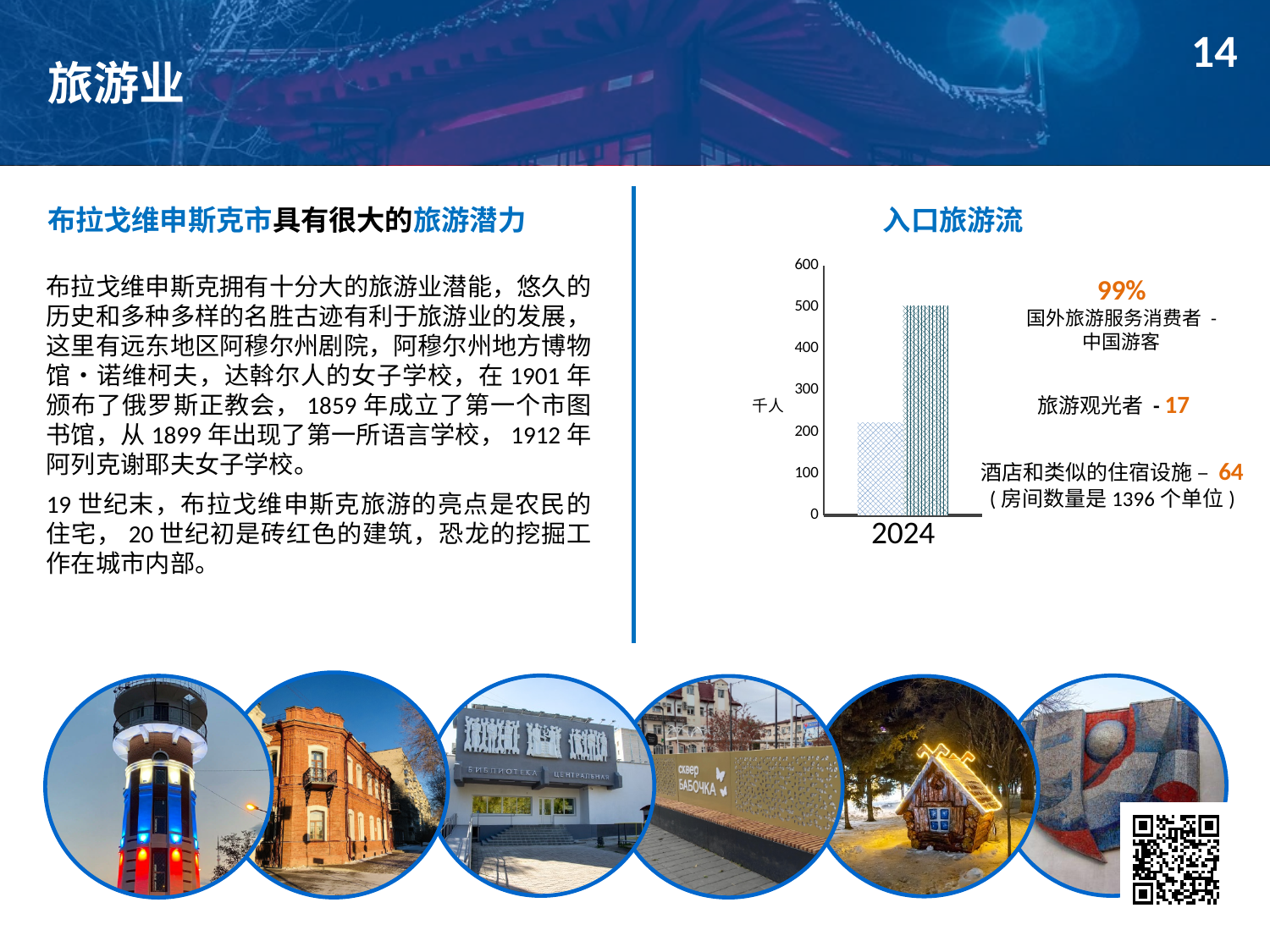
How many bars are plotted in the chart? 2 Is the value of the left (dotted) bar for 2024 greater or less than 300? less Is the value of the right (hatched) bar for 2024 greater or less than 400? greater Is the value of the left (dotted) bar for 2024 greater or less than 100? greater What is the highest tick value shown on the vertical axis of the chart? 600 Which bar for 2024 is taller, the left dotted bar or the right hatched bar? the right hatched bar Which year is shown on the x axis of the chart? 2024 What kind of chart is shown under the title 入口旅游流? bar chart What is the title of the chart on the slide? 入口旅游流 What label is shown on the vertical axis of the chart? 千人 How many categories are shown on the x axis of the chart? 1